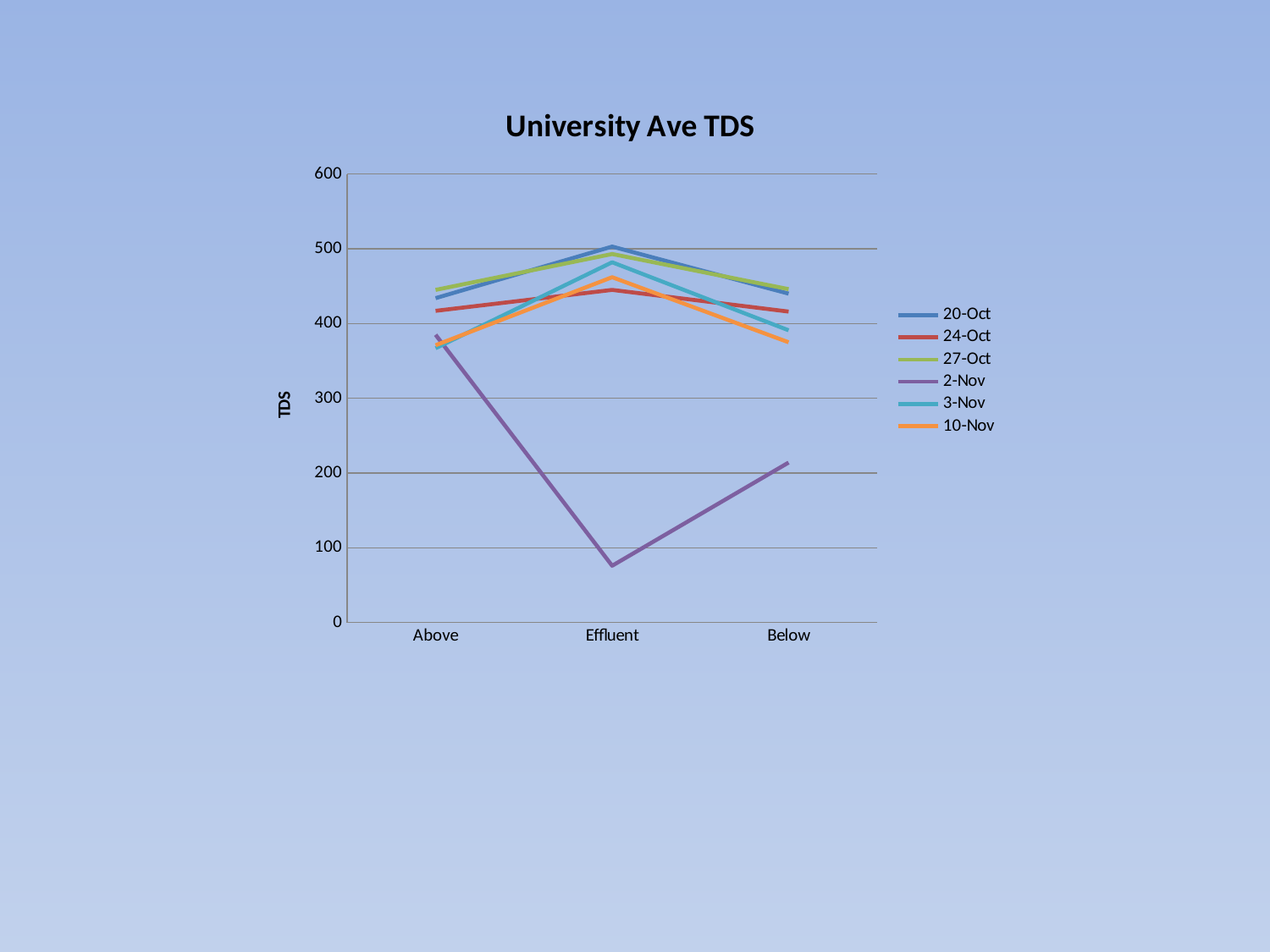
What is the title of the chart? University Ave TDS How many series does the legend list? 6 Is the value for 2-Nov at Below greater or less than 300? less Is the value for 2-Nov at Effluent greater or less than 100? less Does the 2-Nov line rise or fall from Above to Effluent? fall Which series has the lowest value at Effluent? 2-Nov What kind of chart is shown on the slide? line chart Is the value for 20-Oct at Effluent greater or less than 400? greater At Effluent, which is larger: the value for 20-Oct or the value for 24-Oct? 20-Oct How many categories are shown on the x axis? 3 What is the label on the vertical axis? TDS